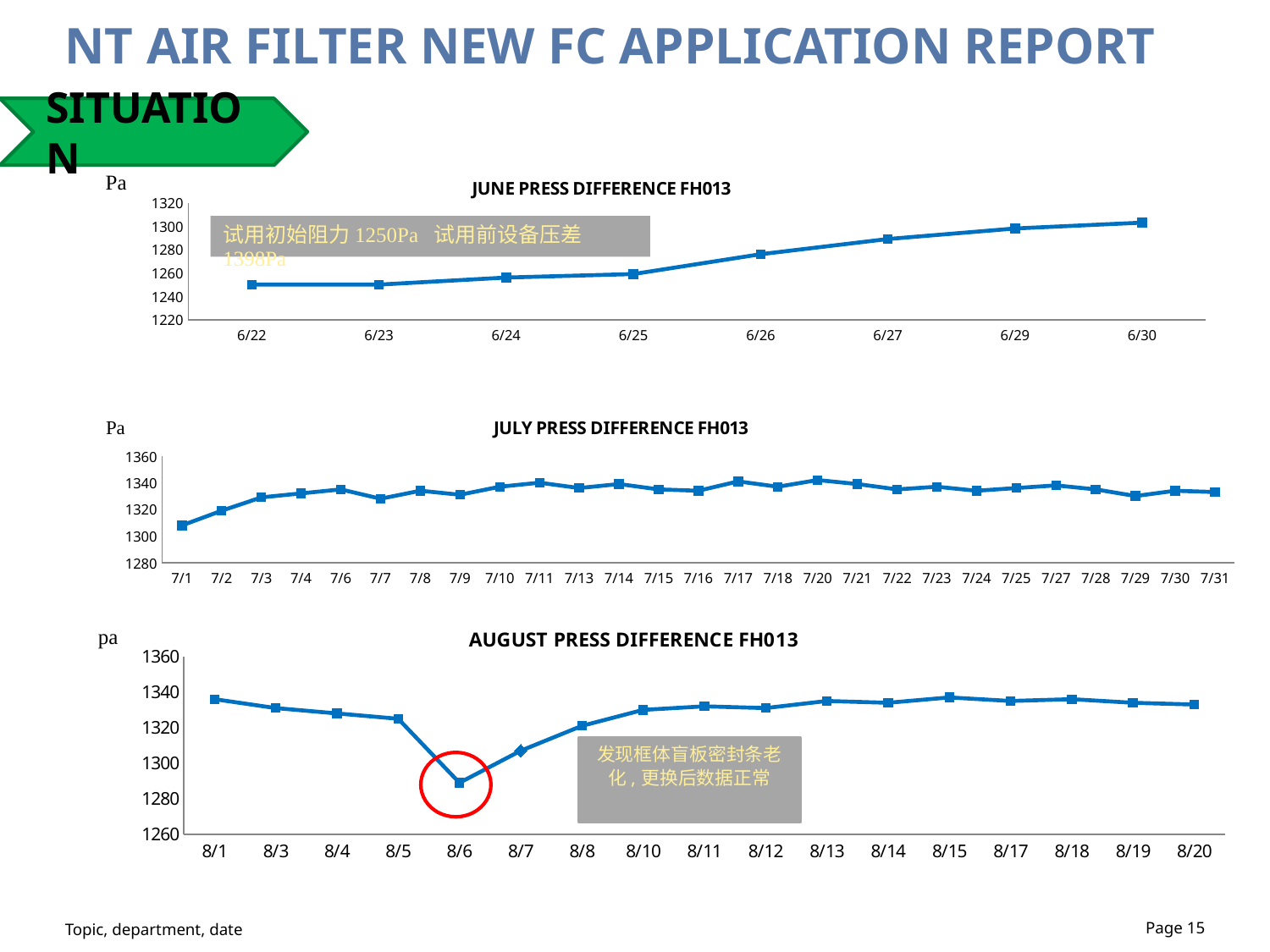
In the JUNE PRESS DIFFERENCE FH013 chart, how many dates are plotted on the x axis? 8 In the AUGUST PRESS DIFFERENCE FH013 chart, which date has the lowest value? 8/6 In the JULY PRESS DIFFERENCE FH013 chart, is the value for 7/1 greater or less than 1320? less In the JULY PRESS DIFFERENCE FH013 chart, which date has the lowest value? 7/1 In the AUGUST PRESS DIFFERENCE FH013 chart, how many dates are plotted on the x axis? 17 In the JUNE PRESS DIFFERENCE FH013 chart, which date has the highest value? 6/30 In the AUGUST PRESS DIFFERENCE FH013 chart, is the value for 8/6 greater or less than 1300? less What kind of chart is the JUNE PRESS DIFFERENCE FH013 chart? line chart In the JULY PRESS DIFFERENCE FH013 chart, which is larger, the value for 7/1 or the value for 7/3? 7/3 In the JUNE PRESS DIFFERENCE FH013 chart, do the values rise or fall from 6/22 to 6/30? rise In the JUNE PRESS DIFFERENCE FH013 chart, is the value for 6/22 greater or less than 1260? less